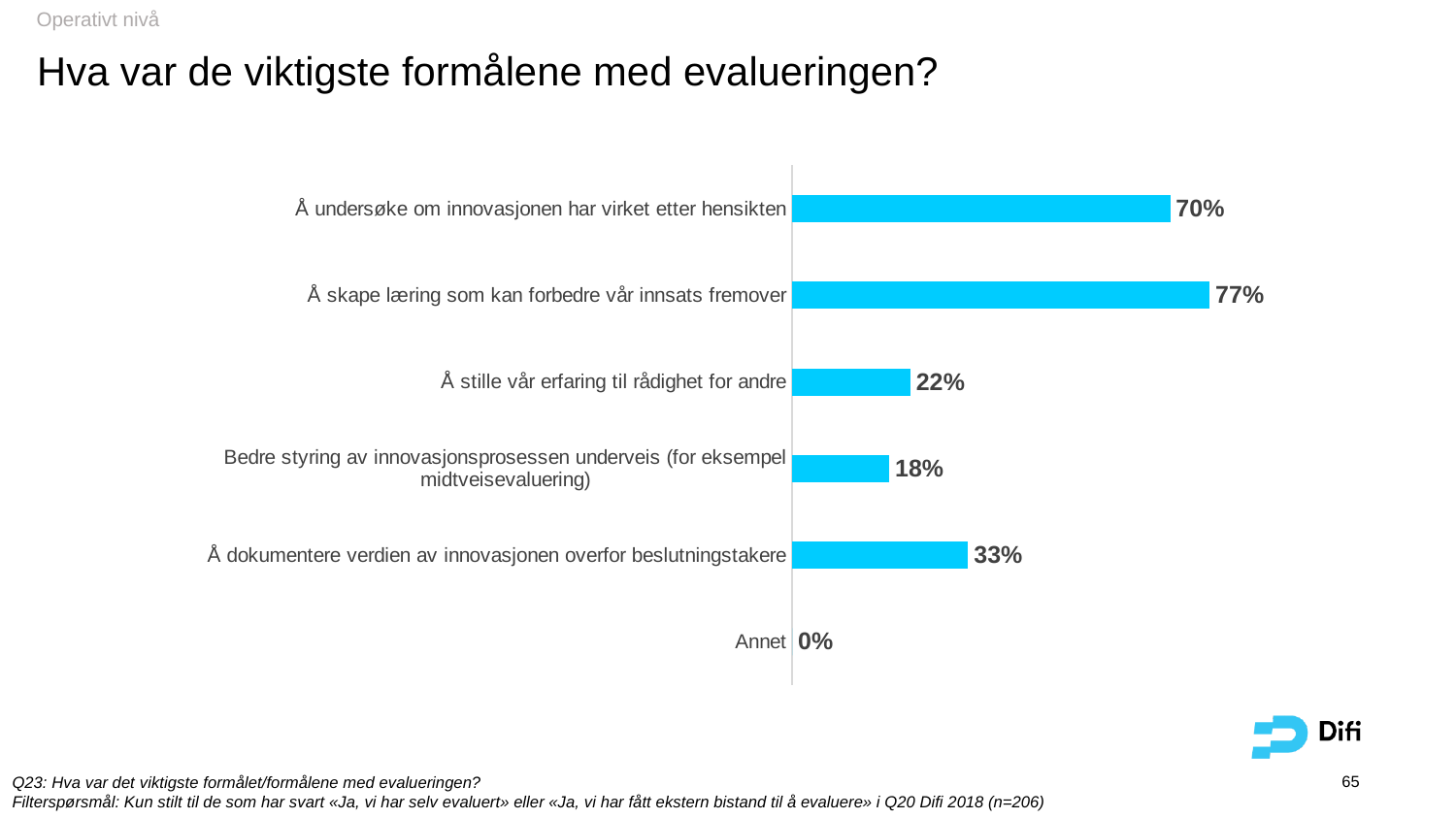
What is the difference between the values for "Å skape læring som kan forbedre vår innsats fremover" and "Å undersøke om innovasjonen har virket etter hensikten"? 7% What is the value for "Bedre styring av innovasjonsprosessen underveis (for eksempel midtveisevaluering)"? 18% What is the difference between the values for "Å dokumentere verdien av innovasjonen overfor beslutningstakere" and "Å stille vår erfaring til rådighet for andre"? 11% How many categories are shown in the chart? 6 What kind of chart is shown on the slide? Bar chart What is the value for "Å stille vår erfaring til rådighet for andre"? 22% What is the title of the slide? Hva var de viktigste formålene med evalueringen? Which is larger: the value for "Å dokumentere verdien av innovasjonen overfor beslutningstakere" or the value for "Å stille vår erfaring til rådighet for andre"? Å dokumentere verdien av innovasjonen overfor beslutningstakere Which category has the lowest value? Annet Which category has the highest value? Å skape læring som kan forbedre vår innsats fremover What is the value for "Annet"? 0% What is the value for "Å undersøke om innovasjonen har virket etter hensikten"? 70%